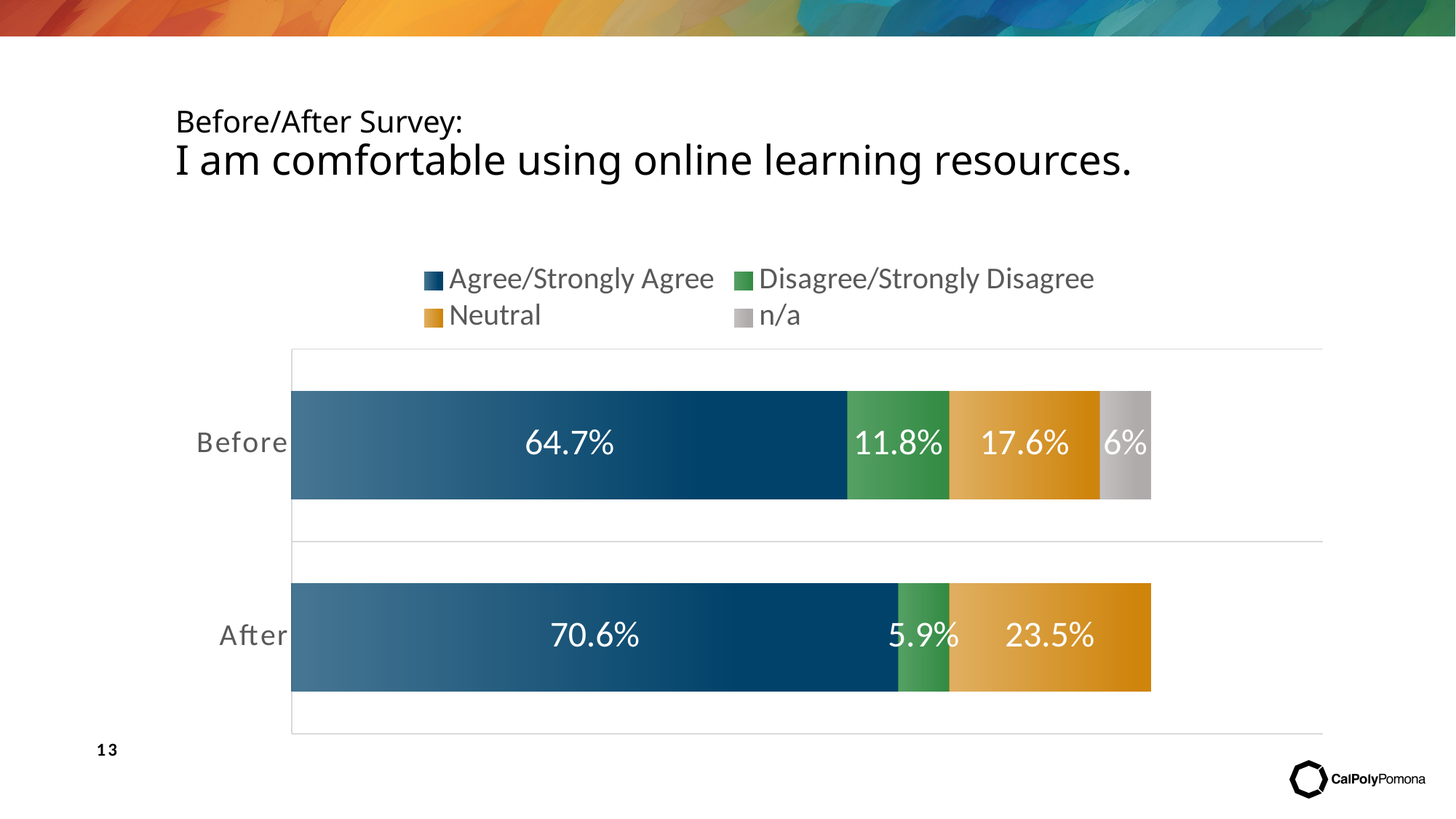
What is the Neutral share in the After survey? 23.5% How many categories (bars) are shown on the chart? 2 What is the Disagree/Strongly Disagree share in the Before survey? 11.8% What percentage of respondents chose Agree/Strongly Agree in the After survey? 70.6% Which survey has the smaller Disagree/Strongly Disagree share, Before or After? After Which colour represents the Neutral series in the chart? Orange What percentage of respondents chose Agree/Strongly Agree in the Before survey? 64.7% What kind of chart is shown on the slide? Stacked bar chart What is the n/a share in the Before survey? 6% How many series does the legend list? 4 Which survey has the larger Neutral share, Before or After? After By how many percentage points did Agree/Strongly Agree increase from Before to After? 5.9